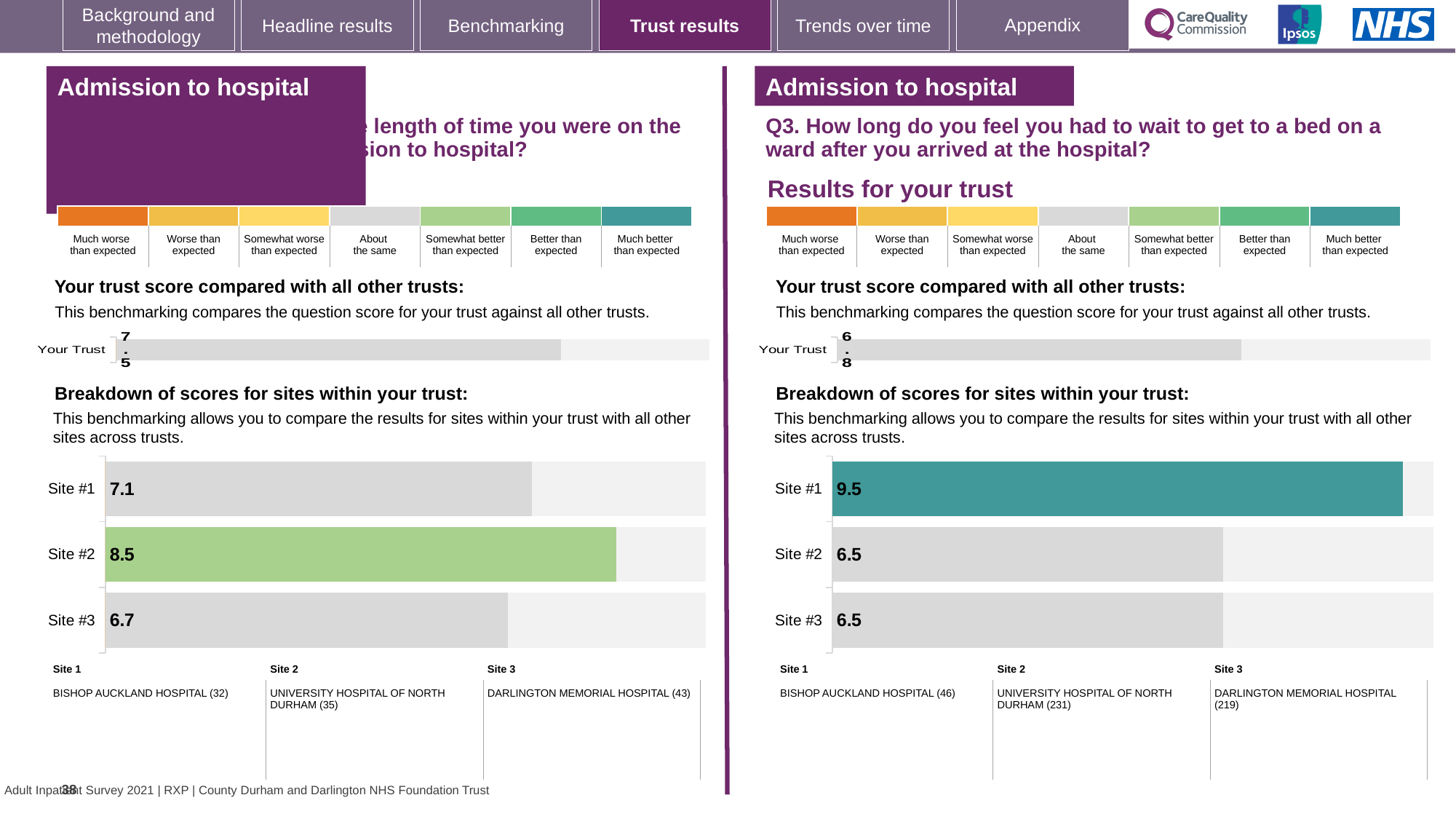
How many sites are shown in the site breakdown chart on the right half of the slide (Q3)? 3 What type of chart is used for the breakdown of scores for sites on the left half of the slide? Bar chart In the site breakdown chart on the right half of the slide (Q3), what is the difference between the scores for Site #1 and Site #2? 3.0 In the site breakdown chart on the right half of the slide (Q3), what colour is the bar for Site #1? Teal In the site breakdown chart on the left half of the slide, which is larger: the score for Site #1 or Site #3? Site #1 In the site breakdown chart on the left half of the slide, what is the difference between the scores for Site #2 and Site #3? 1.8 In the 'Your trust score compared with all other trusts' chart on the left half of the slide, what is the score for Your Trust? 7.5 In the 'Your trust score compared with all other trusts' chart on the right half of the slide (Q3), what is the score for Your Trust? 6.8 In the site breakdown chart on the right half of the slide (Q3), what is the score for Site #1? 9.5 In the site breakdown chart on the right half of the slide (Q3), which site has the highest score? Site #1 In the site breakdown chart on the left half of the slide, what is the score for Site #2? 8.5 In the site breakdown chart on the left half of the slide, which site has the lowest score? Site #3